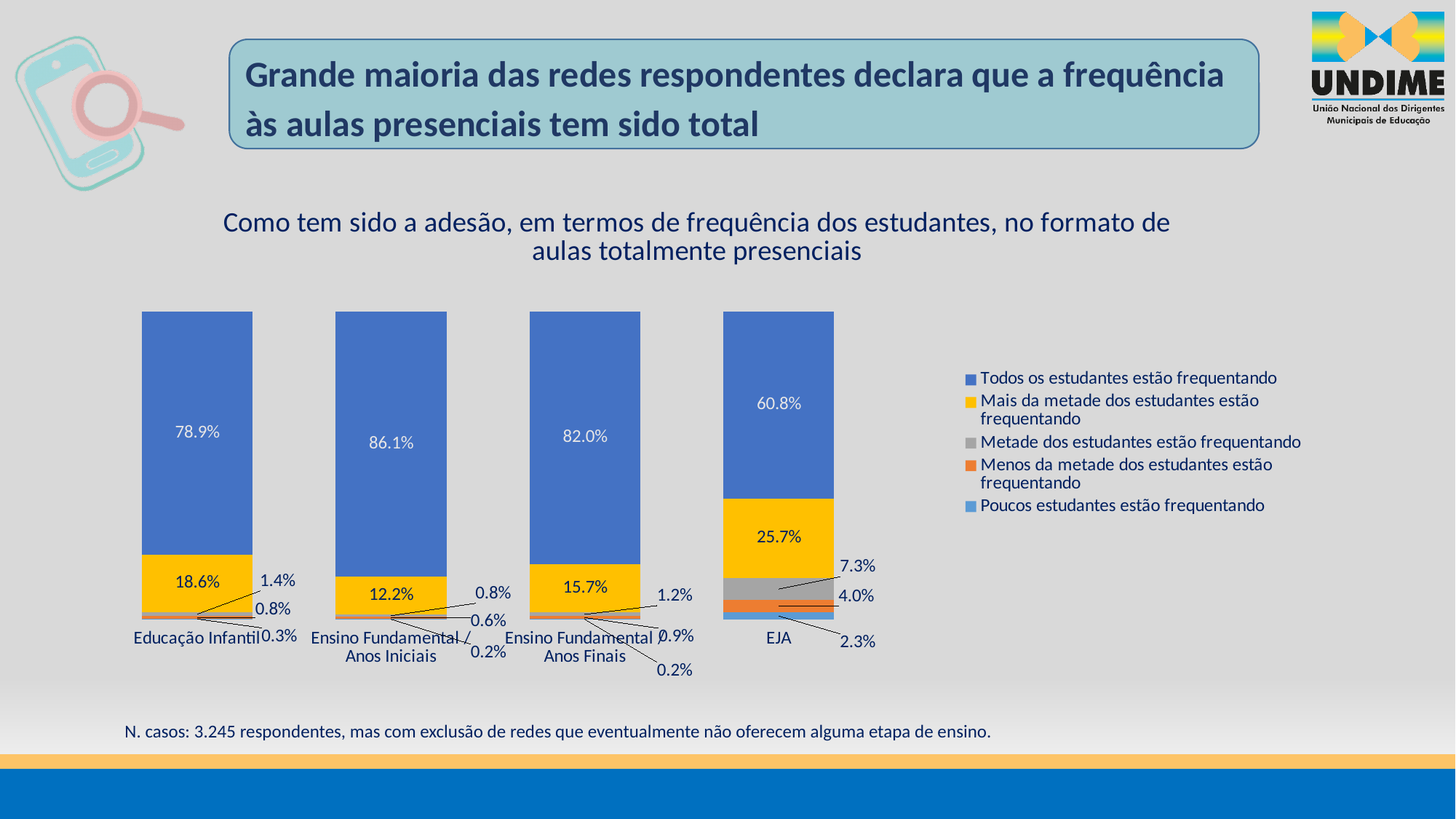
What percentage of respondents for Educação Infantil said all students are attending (Todos os estudantes estão frequentando)? 78.9% Which colour represents 'Poucos estudantes estão frequentando' in the legend? Light blue How many series does the legend list? 5 What is the value of 'Metade dos estudantes estão frequentando' for EJA? 7.3% How many categories are shown on the x axis of the chart? 4 What is the value of 'Mais da metade dos estudantes estão frequentando' for EJA? 25.7% What type of chart is shown on the slide? Stacked bar chart What is the difference between the 'Todos os estudantes estão frequentando' values for Ensino Fundamental Anos Iniciais and EJA? 25.3 percentage points Which category has the lowest value for 'Todos os estudantes estão frequentando'? EJA Which category has the highest value for 'Todos os estudantes estão frequentando'? Ensino Fundamental Anos Iniciais Which is larger: the 'Mais da metade dos estudantes estão frequentando' value for Educação Infantil or for Ensino Fundamental Anos Finais? Educação Infantil What is the value of 'Todos os estudantes estão frequentando' for Ensino Fundamental Anos Finais? 82.0%